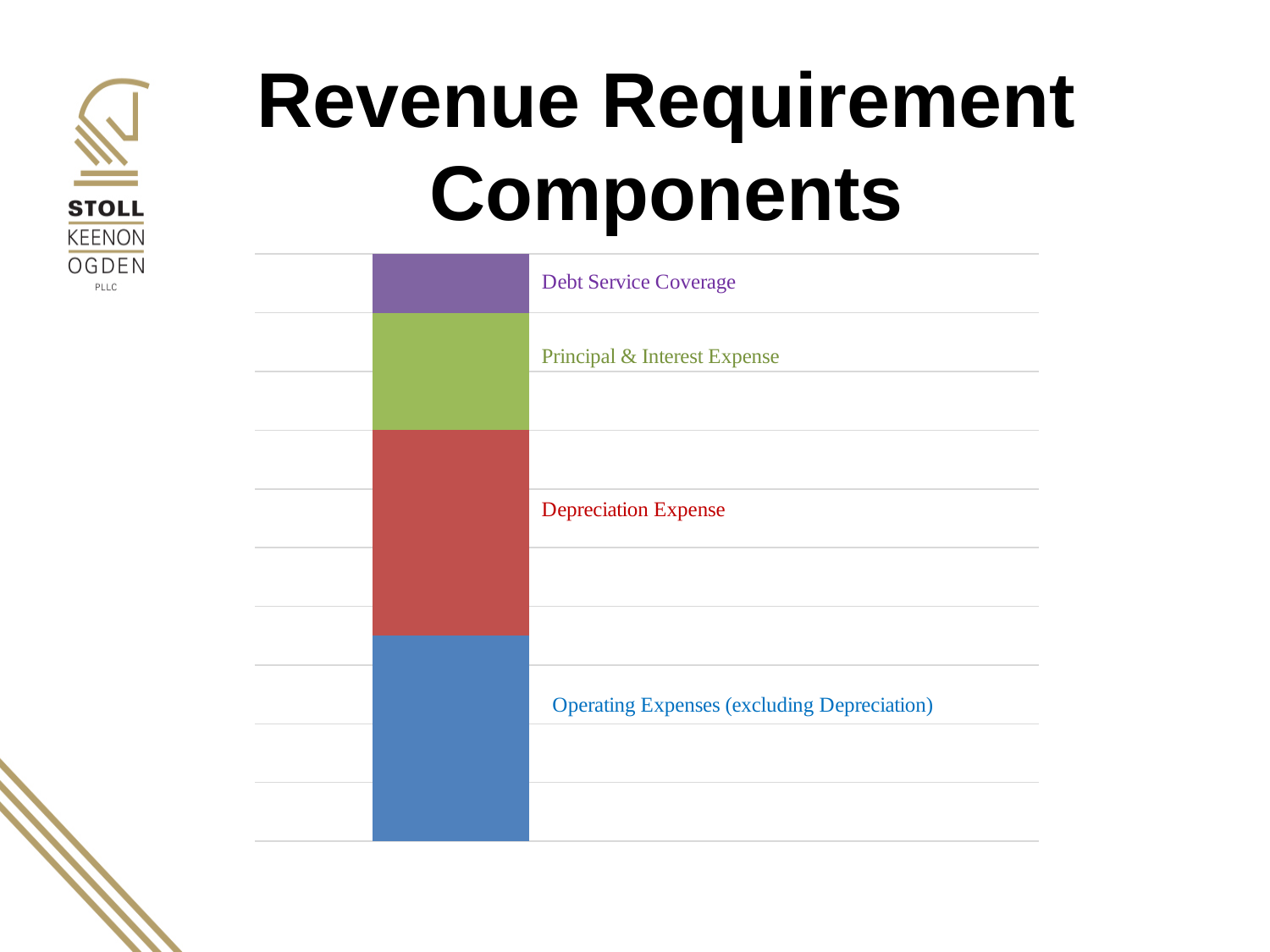
Which component is shown at the top of the stacked bar? Debt Service Coverage Which component occupies the smallest segment of the stacked bar? Debt Service Coverage What is the title of the slide's chart? Revenue Requirement Components Which component is shown at the bottom of the stacked bar? Operating Expenses (excluding Depreciation) Which segment is larger: Principal & Interest Expense or Debt Service Coverage? Principal & Interest Expense How many components (segments) make up the stacked bar? 4 Which segment is larger: Depreciation Expense or Principal & Interest Expense? Depreciation Expense What kind of chart is shown on the slide? Stacked bar chart